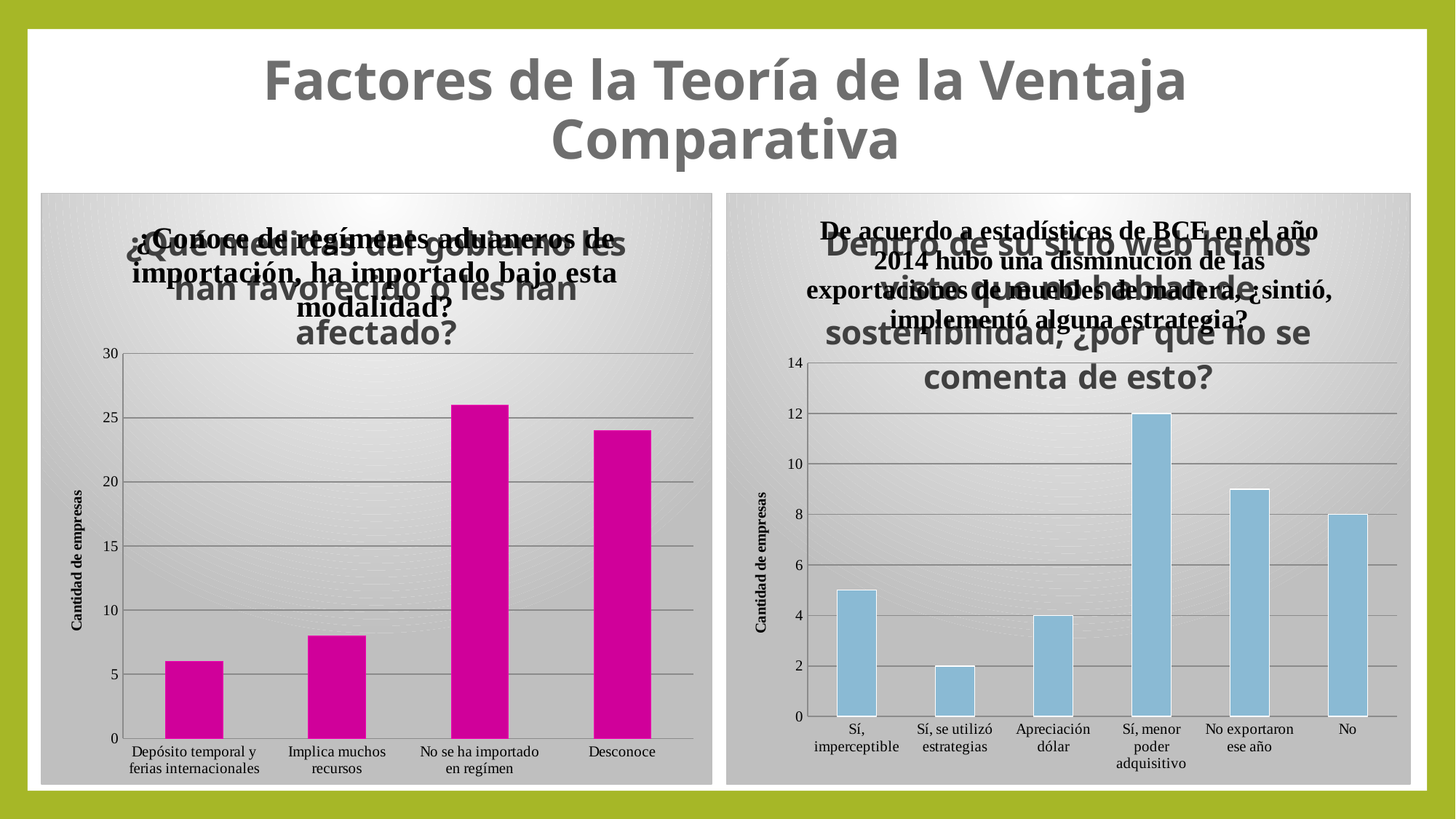
In the left chart, is the value for Desconoce greater or less than 20? greater In the left chart, which category has the highest value? No se ha importado en regímen In the right chart, what is the value for Sí, se utilizó estrategias? 2 In the left chart, which is larger: Implica muchos recursos or Depósito temporal y ferias internacionales? Implica muchos recursos In the right chart, is the value for No exportaron ese año greater or less than 8? greater What is the y-axis label of the right chart? Cantidad de empresas In the right chart, what is the value for Sí, menor poder adquisitivo? 12 How many categories does the right chart show? 6 How many categories does the left chart show? 4 In the left chart, which category has the lowest value? Depósito temporal y ferias internacionales In the right chart, what is the difference between Sí, menor poder adquisitivo and Sí, se utilizó estrategias? 10 What kind of chart is the left chart on the slide? bar chart